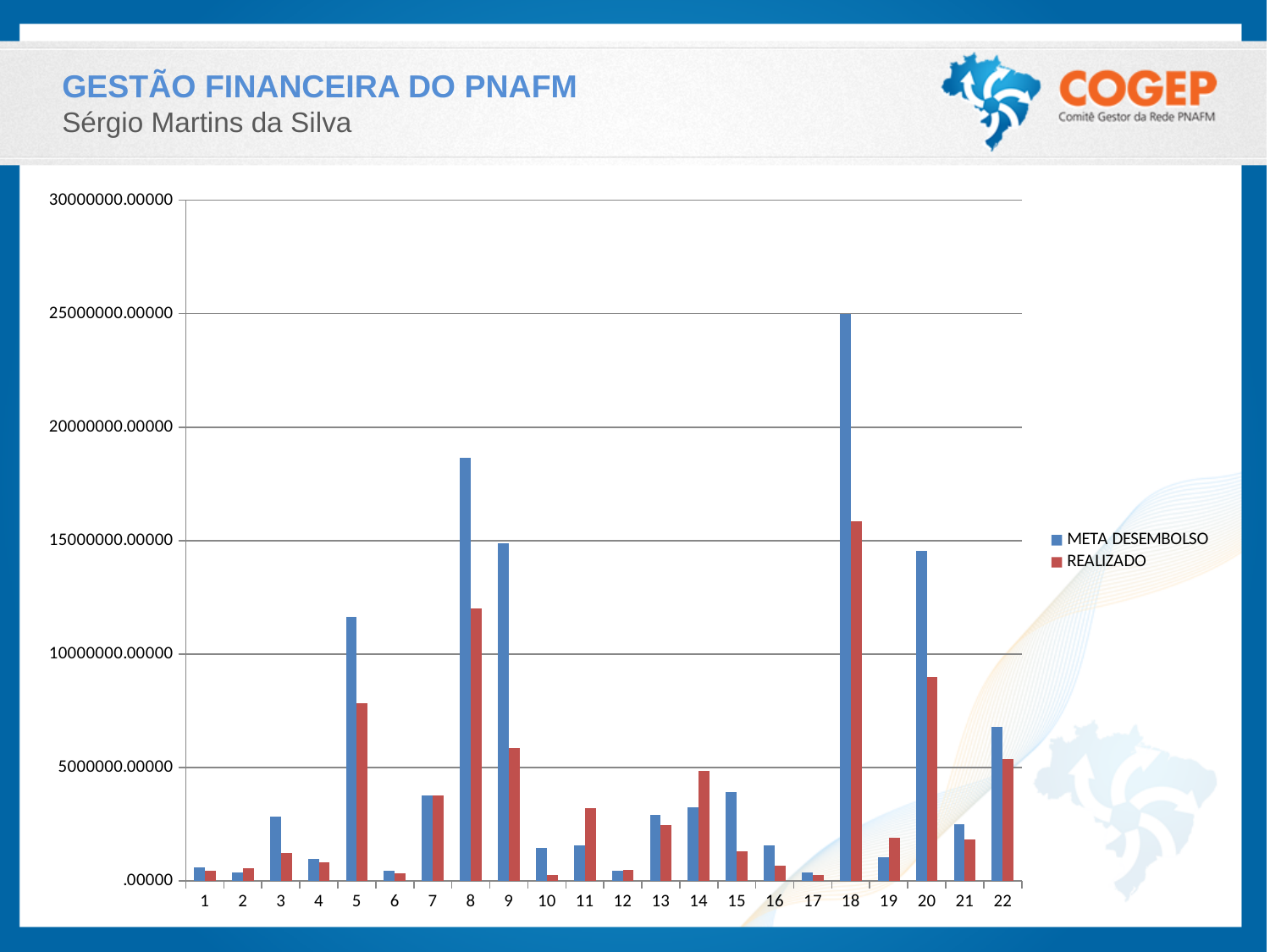
For category 5, which series has the larger value, META DESEMBOLSO or REALIZADO? META DESEMBOLSO Is the META DESEMBOLSO value for category 18 greater or less than 20000000.00000? greater How many series does the legend list? 2 For category 14, which series has the larger value, META DESEMBOLSO or REALIZADO? REALIZADO Which category has the highest REALIZADO value? 18 How many categories are shown on the x axis? 22 What kind of chart is shown on the slide? bar chart Which category has the highest META DESEMBOLSO value? 18 Is the META DESEMBOLSO value for category 8 greater or less than 15000000.00000? greater Is the REALIZADO value for category 20 greater or less than 10000000.00000? less What are the two series named in the legend? META DESEMBOLSO and REALIZADO